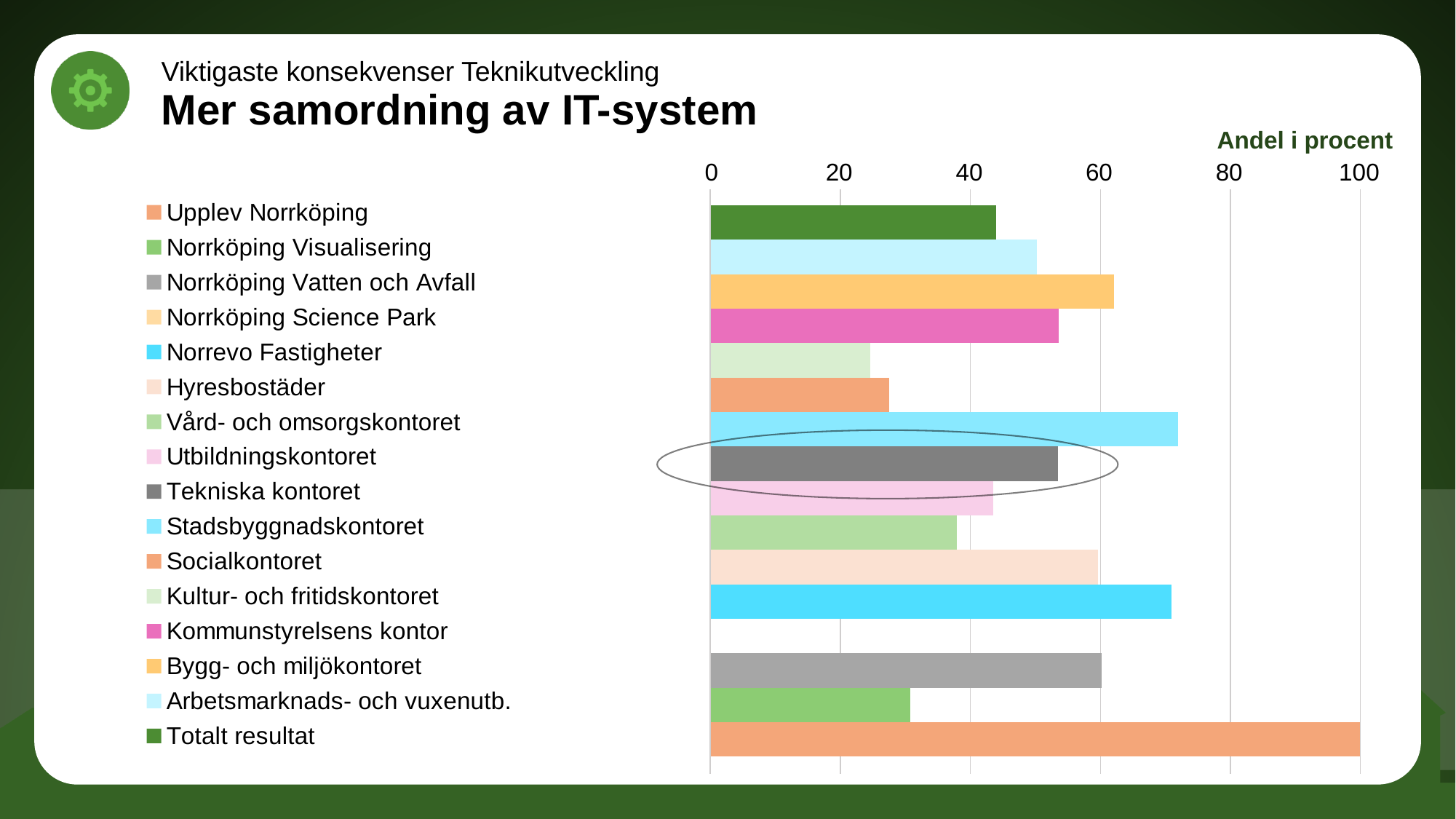
Is the value for Norrevo Fastigheter greater or less than 60? greater Which is larger, the value for Norrevo Fastigheter or the value for Norrköping Visualisering? Norrevo Fastigheter Is the value for Stadsbyggnadskontoret greater or less than 60? greater Which is larger, the value for Stadsbyggnadskontoret or the value for Socialkontoret? Stadsbyggnadskontoret How many entries does the legend list? 16 What is the label shown above the horizontal axis of the chart? Andel i procent Is the value for Kultur- och fritidskontoret greater or less than 40? less What kind of chart is shown on the slide? bar chart What is the value for Upplev Norrköping? 100 Which category has the highest value in the chart? Upplev Norrköping